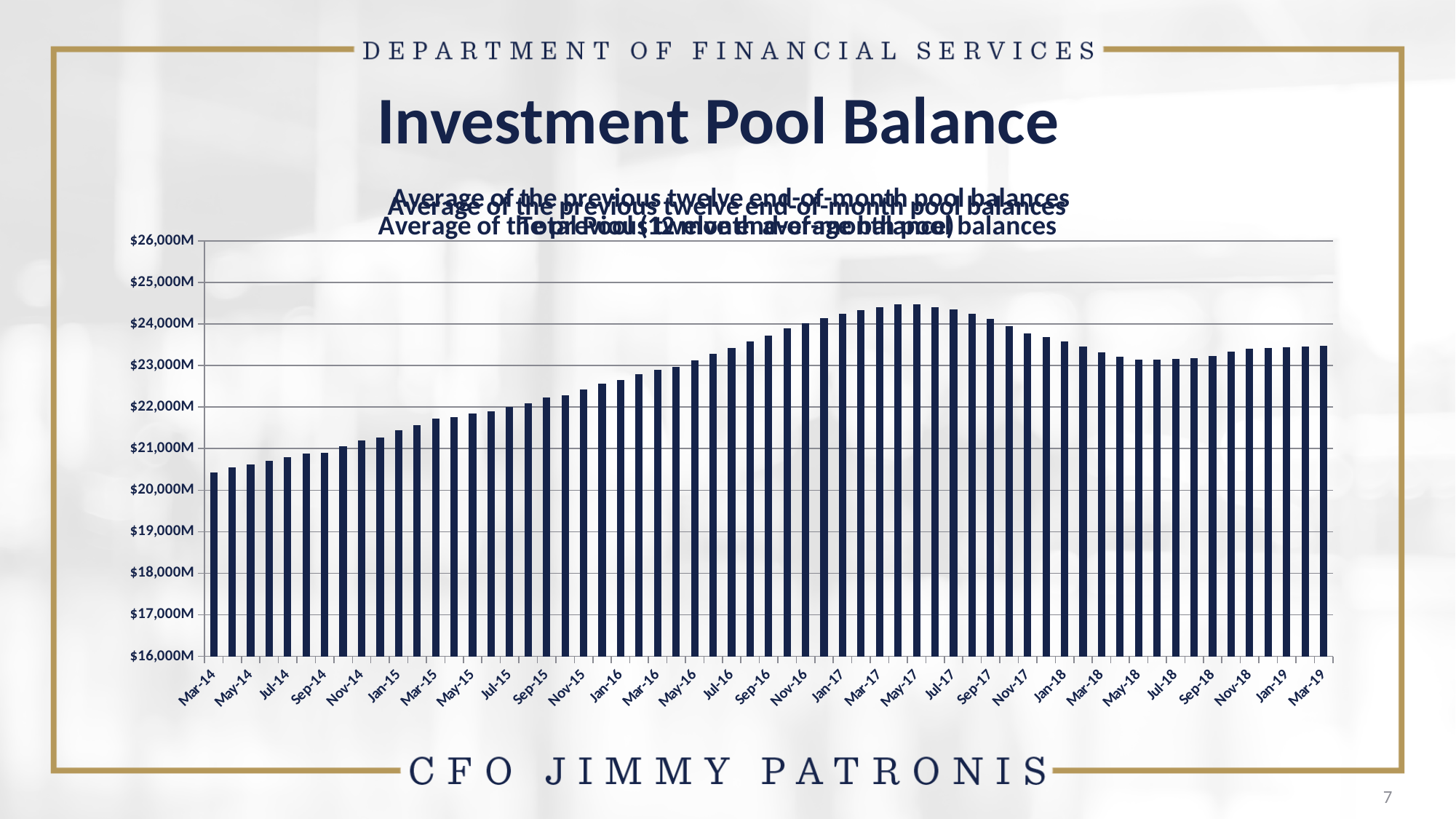
Which is larger, the value for Jan-17 or the value for Jan-19? Jan-17 Do the values rise or fall from Mar-14 to Mar-17? rise Is the value for Jan-16 greater or less than $22,000M? greater Is the value for May-17 greater or less than $24,000M? greater Is the value for Mar-14 greater or less than $21,000M? less Which is larger, the value for Mar-14 or the value for Mar-19? Mar-19 Which month has the lowest value on the chart? Mar-14 What is the highest value shown on the y axis? $26,000M Do the values rise or fall from Jul-17 to May-18? fall What kind of chart is shown on the slide? bar chart